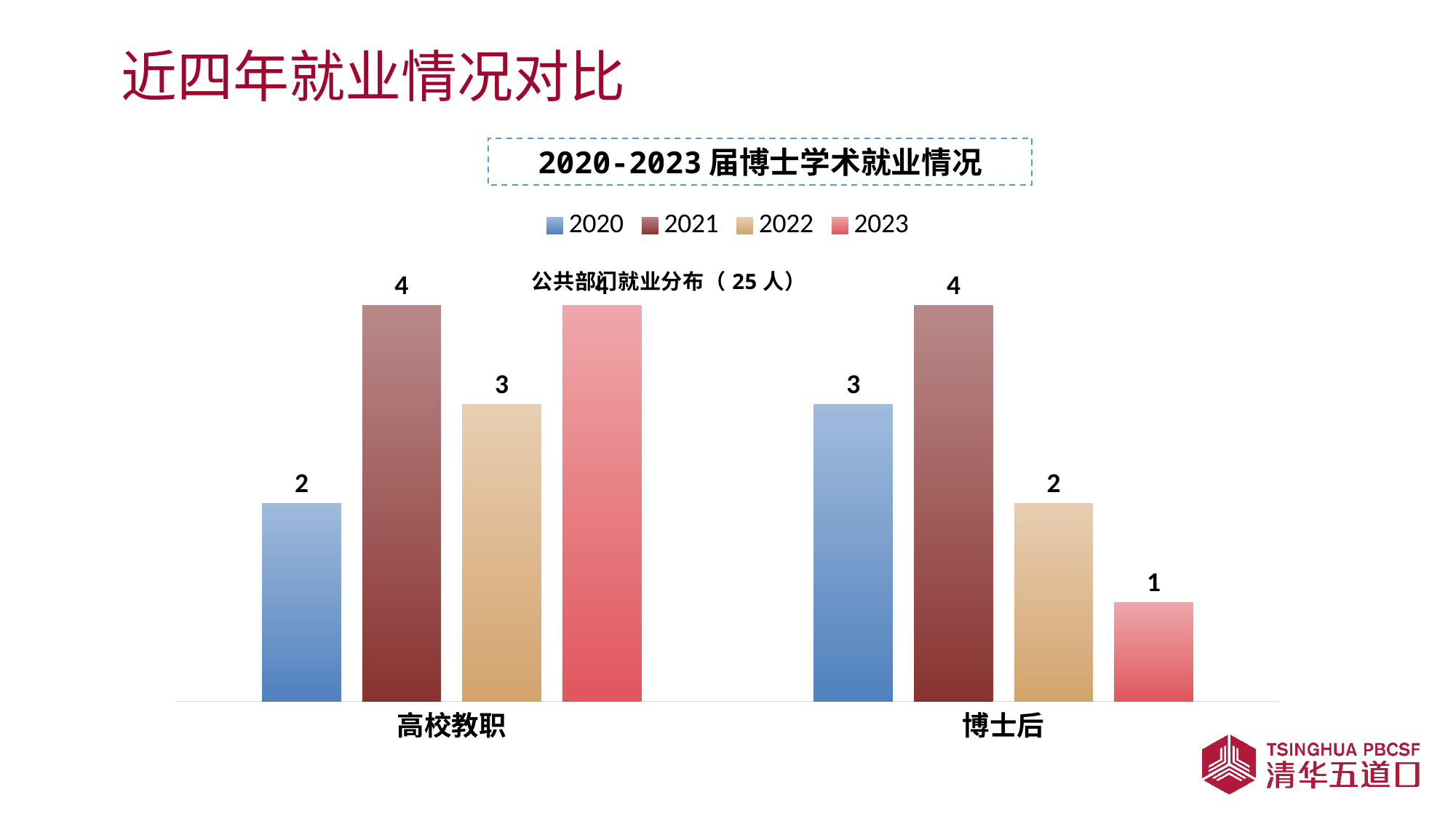
How many series does the legend list? 4 What is the title of the chart? 2020-2023 届博士学术就业情况 What is the value for 2022 in the 高校教职 category? 3 What is the difference between the 2021 and 2020 values in the 高校教职 category? 2 What is the value for 2023 in the 博士后 category? 1 How many categories are shown on the x axis? 2 What is the value for 2021 in the 高校教职 category? 4 Which year has the lowest value in the 博士后 category? 2023 Which year has the lowest value in the 高校教职 category? 2020 What is the value for 2020 in the 博士后 category? 3 What kind of chart is shown on the slide? Bar chart Which is larger in the 博士后 category, the value for 2020 or the value for 2022? 2020